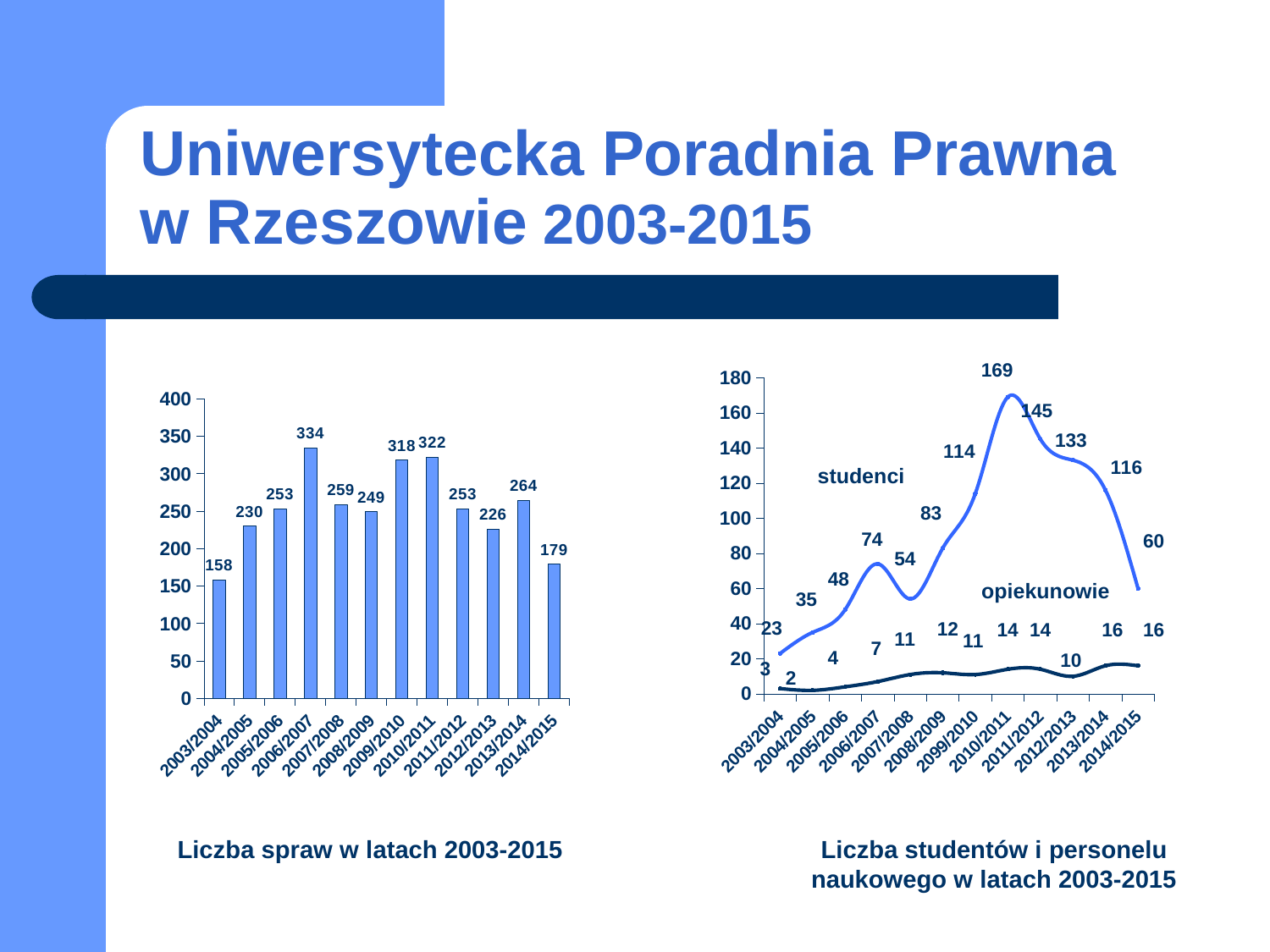
In the right chart (Liczba studentów i personelu naukowego), what is the difference between studenci and opiekunowie in 2014/2015? 44 In the right chart (Liczba studentów i personelu naukowego), which series has the higher value in 2006/2007, studenci or opiekunowie? studenci What type of chart is the left chart (Liczba spraw w latach 2003-2015)? Bar chart In the left chart (Liczba spraw w latach 2003-2015), which year has the highest value? 2006/2007 In the left chart (Liczba spraw w latach 2003-2015), which year has the lowest number of cases? 2003/2004 In the right chart (Liczba studentów i personelu naukowego), how many series are plotted? 2 In the left chart (Liczba spraw w latach 2003-2015), what is the value for 2006/2007? 334 What type of chart is the right chart (Liczba studentów i personelu naukowego)? Line chart In the left chart (Liczba spraw w latach 2003-2015), how many years are shown on the x axis? 12 In the left chart (Liczba spraw w latach 2003-2015), what is the difference between the values for 2010/2011 and 2014/2015? 143 In the right chart (Liczba studentów i personelu naukowego), what is the value for opiekunowie in 2012/2013? 10 In the right chart (Liczba studentów i personelu naukowego), what is the value for studenci in 2010/2011? 169